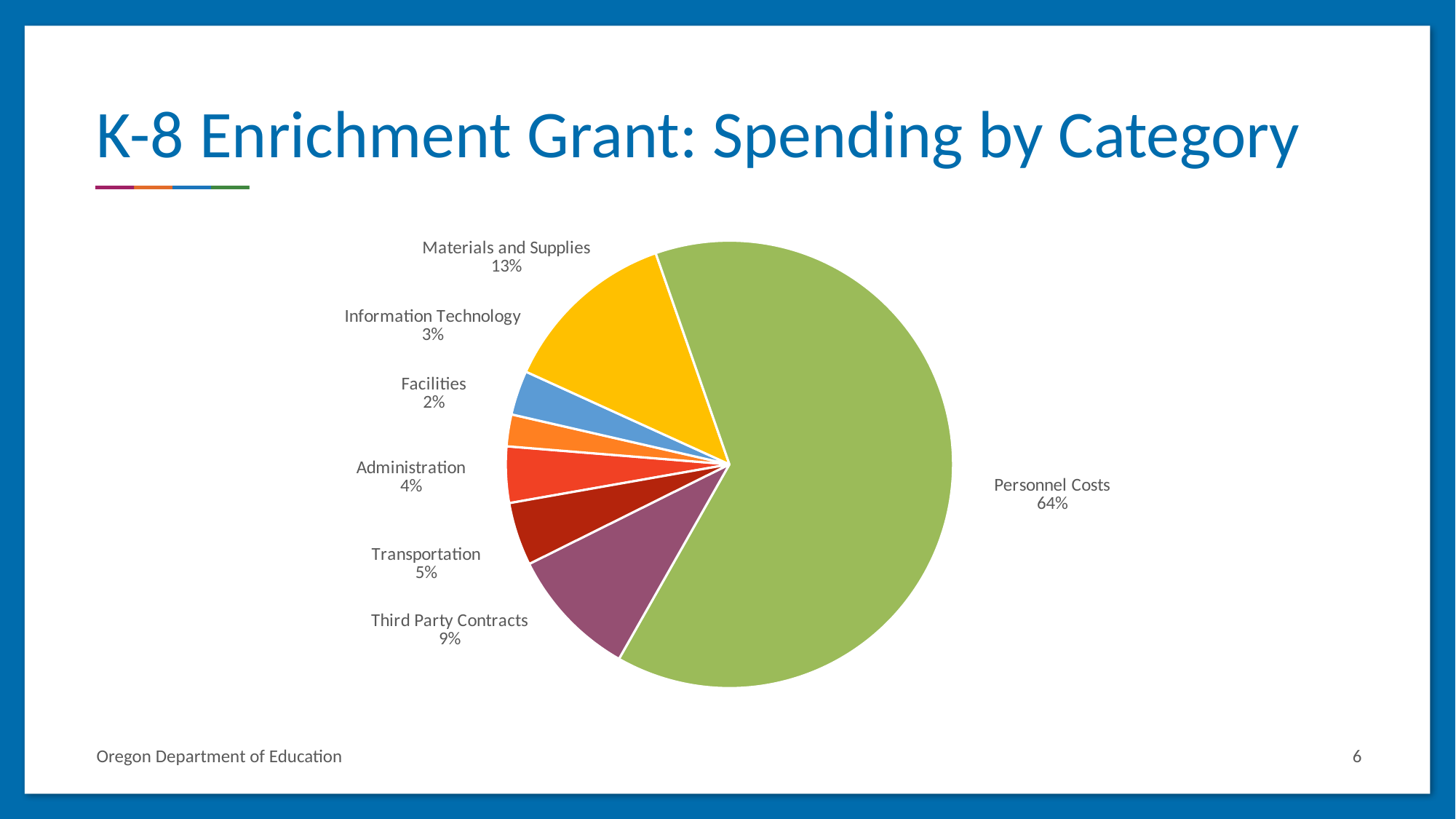
What kind of chart is shown on the slide? pie chart How many categories are shown in the pie chart? 7 What percentage of spending is for Materials and Supplies? 13% Which category has the largest share of spending? Personnel Costs What share of spending goes to Personnel Costs? 64% What percentage is shown for Transportation? 5% Which category has the smallest share of spending? Facilities What is the difference in percentage points between Materials and Supplies and Third Party Contracts? 4 What share of spending is Third Party Contracts? 9% What is the title of the slide containing the chart? K-8 Enrichment Grant: Spending by Category What is the combined share of Transportation and Administration? 9% Which is larger, the share for Administration or the share for Information Technology? Administration